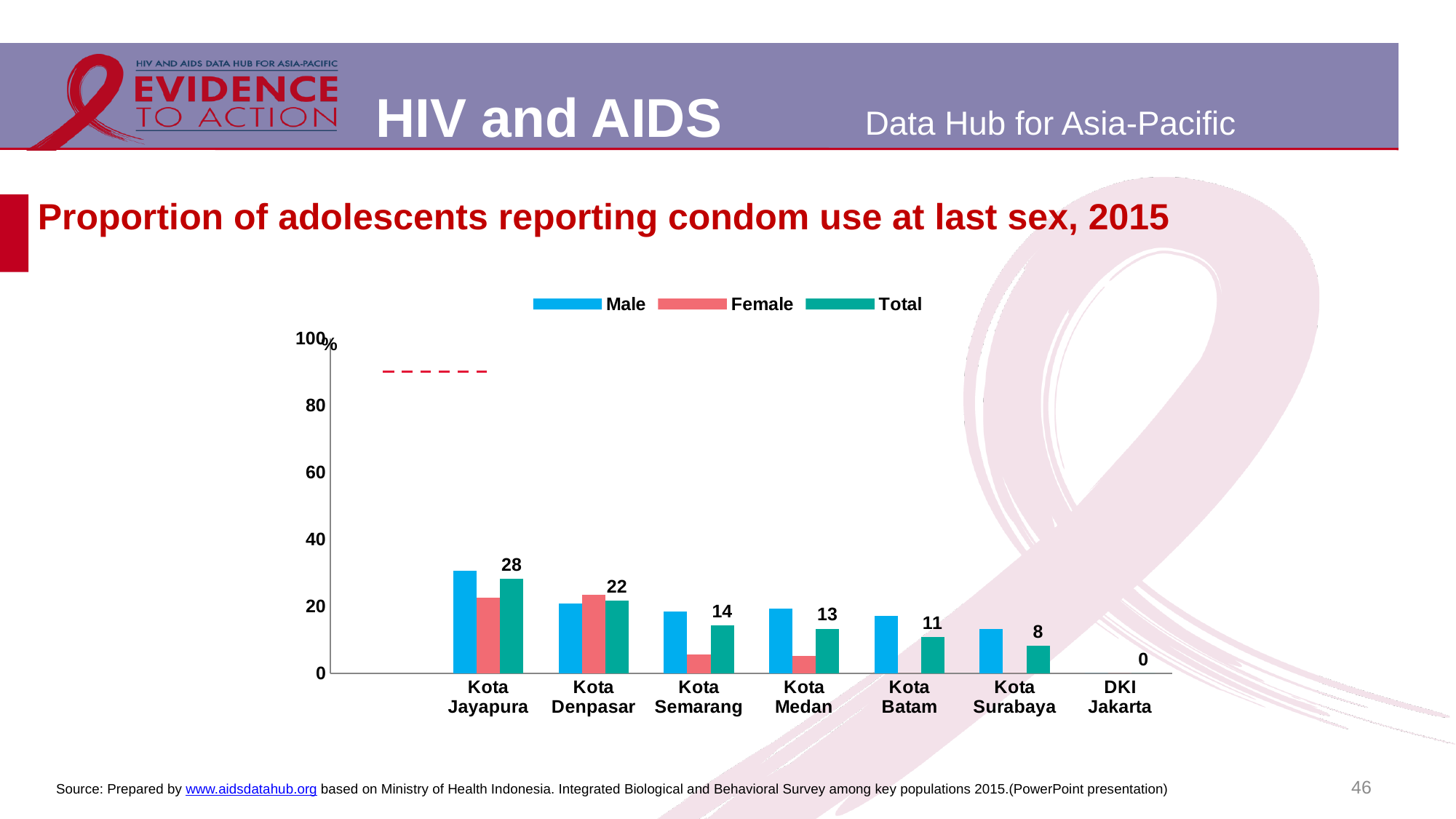
What is the Total value for Kota Semarang? 14 In Kota Semarang, which is larger, the Male bar or the Female bar? Male What is the Total value for DKI Jakarta? 0 Which city has the highest Total value? Kota Jayapura How many series does the legend list? 3 How many cities are shown on the x axis? 7 Do the Total values rise or fall from left to right across the cities? fall What is the difference between the Total values for Kota Jayapura and Kota Surabaya? 20 Which is larger, the Total value for Kota Denpasar or for Kota Medan? Kota Denpasar Is the Male value for Kota Jayapura greater or less than 20? greater Which city has the lowest Total value? DKI Jakarta What is the Total value for Kota Jayapura? 28